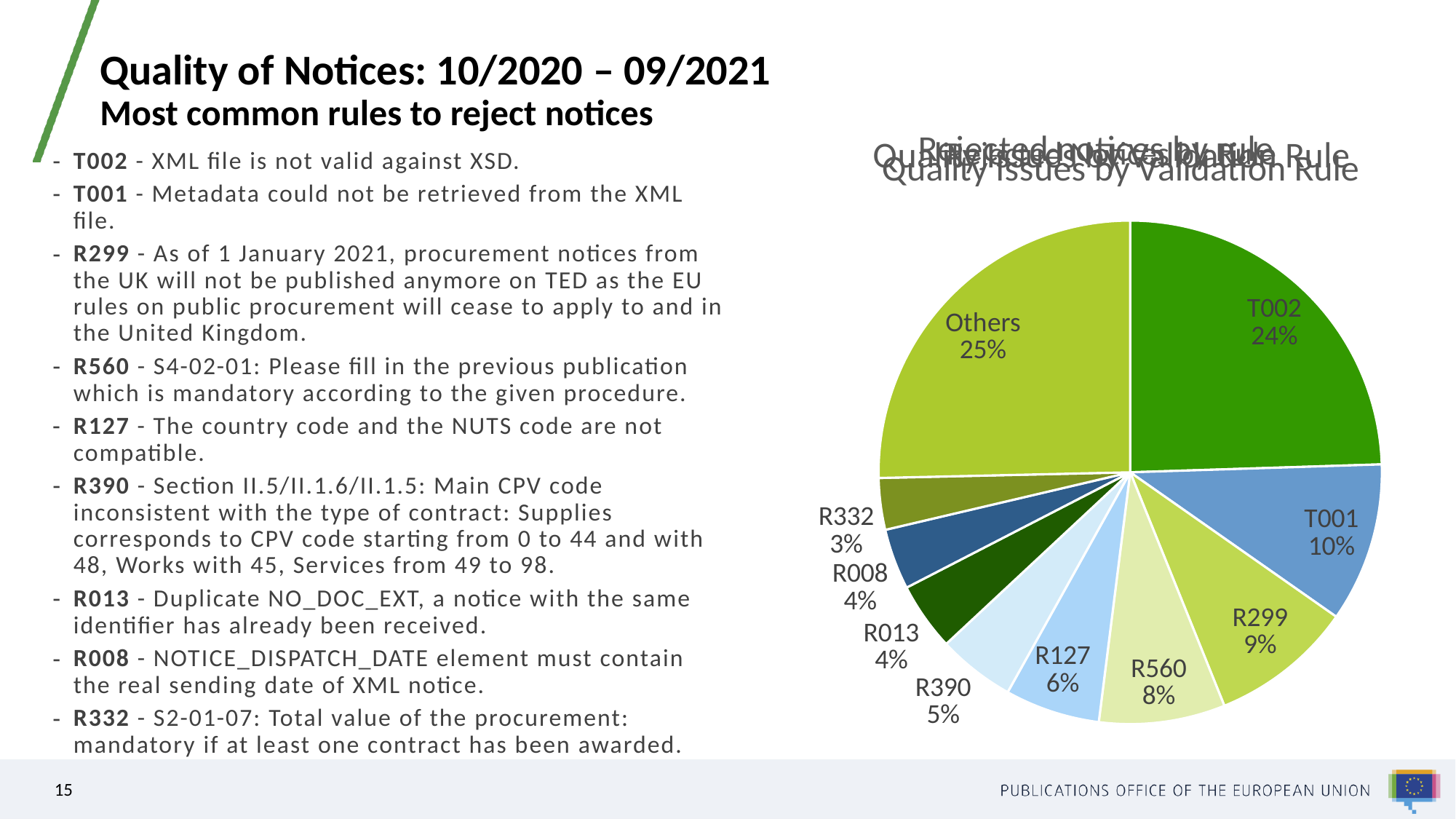
What is the combined share of R013 and R008? 8% What is the value shown for R560? 8% Which is larger, the share for R127 or the share for R390? R127 Which slice of the pie is the smallest? R332 What is the value shown for R332? 3% How many slices does the pie chart have? 10 What is the value shown for R299? 9% What share of the pie does T001 have? 10% What kind of chart is shown on the slide? pie chart Which slice of the pie is the largest? Others What is the difference between the shares of T002 and T001? 14% What share of the pie does T002 have? 24%